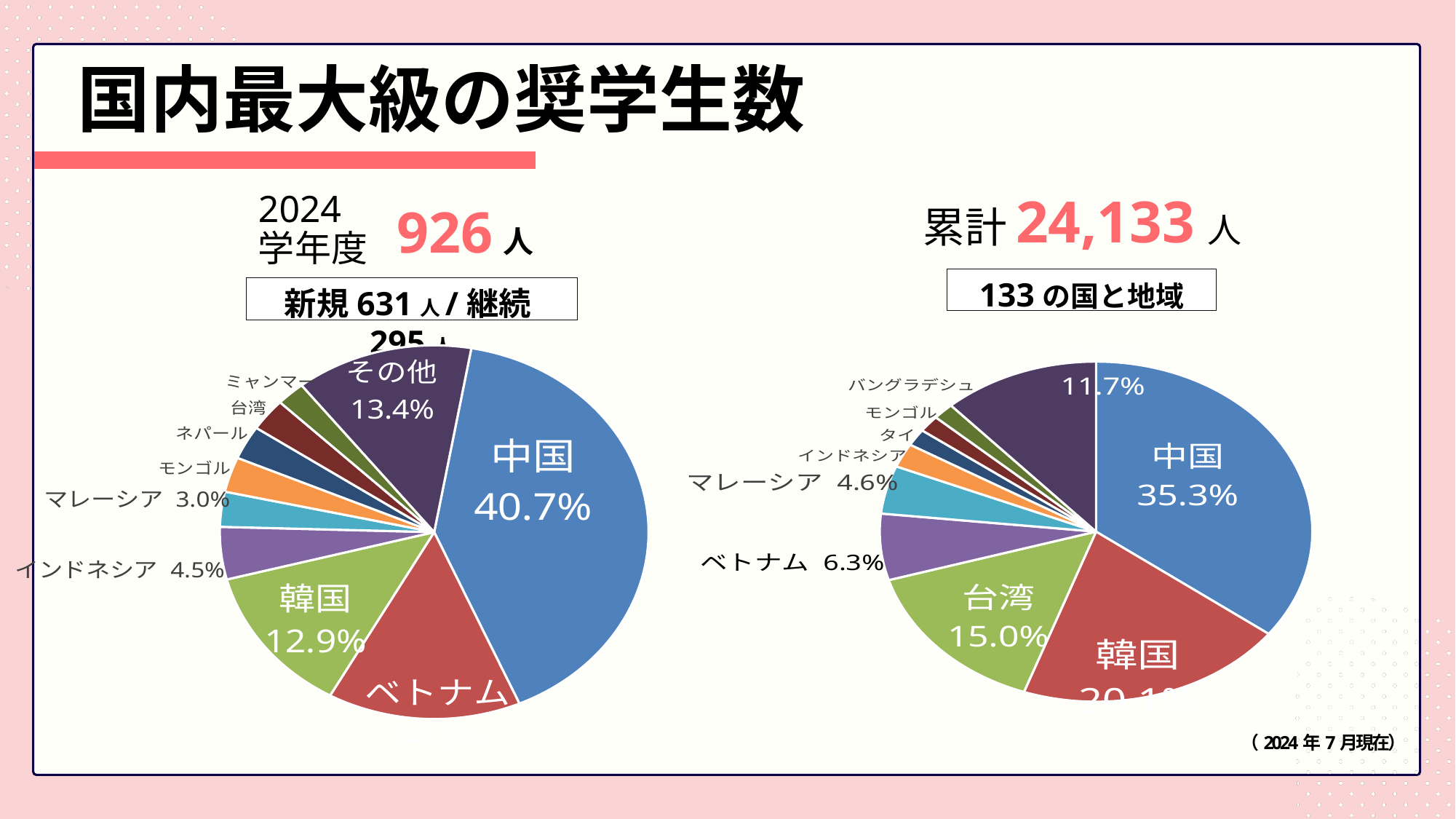
In the left pie chart (2024学年度), what share does その他 have? 13.4% In the right pie chart (累計), which is larger, 台湾 or ベトナム? 台湾 In the left pie chart (2024学年度), what is the difference in percentage points between 中国 and 韓国? 27.8 In the right pie chart (累計), what share does 台湾 have? 15.0% In the left pie chart (2024学年度), what share does インドネシア have? 4.5% In the left pie chart (2024学年度), how many slices does the pie have? 10 In the left pie chart (2024学年度), which category has the largest slice? 中国 In the left pie chart (2024学年度), what share does 韓国 have? 12.9% In the left pie chart (2024学年度), what share does 中国 have? 40.7% In the right pie chart (累計), what share does 中国 have? 35.3% What kind of chart is used on the left side of the slide (2024学年度)? pie chart In the right pie chart (累計), what is the difference in percentage points between 中国 and 台湾? 20.3